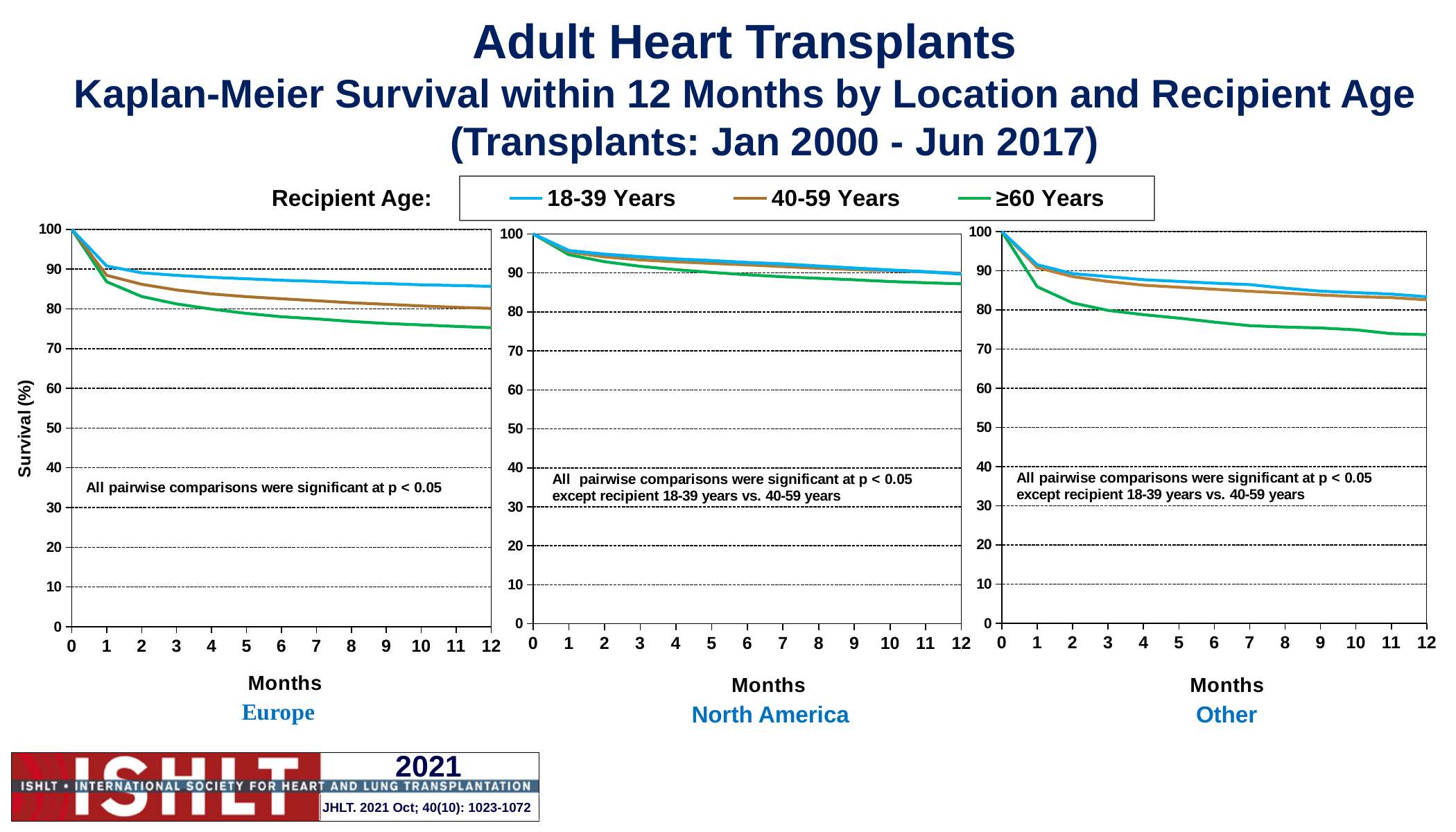
In the Europe chart, which recipient age group has the lowest survival at 12 months? ≥60 Years In the North America chart, do the survival curves rise or fall as months increase? fall How many series does the legend list? 3 What is the survival value for all age groups at month 0 in the Europe chart? 100 In the Europe chart, which recipient age group has the highest survival at 12 months? 18-39 Years In the Europe chart, is the survival for 18-39 Years at 12 months greater or less than 80? greater What kind of chart is the Europe chart? line chart In the North America chart, is the survival for ≥60 Years at 12 months greater or less than 90? less In the Other chart, which is larger at 12 months, the survival for 18-39 Years or for ≥60 Years? 18-39 Years In the North America chart, which recipient age group has the lowest survival at 12 months? ≥60 Years In the Europe chart, is the survival for ≥60 Years at 12 months greater or less than 80? less